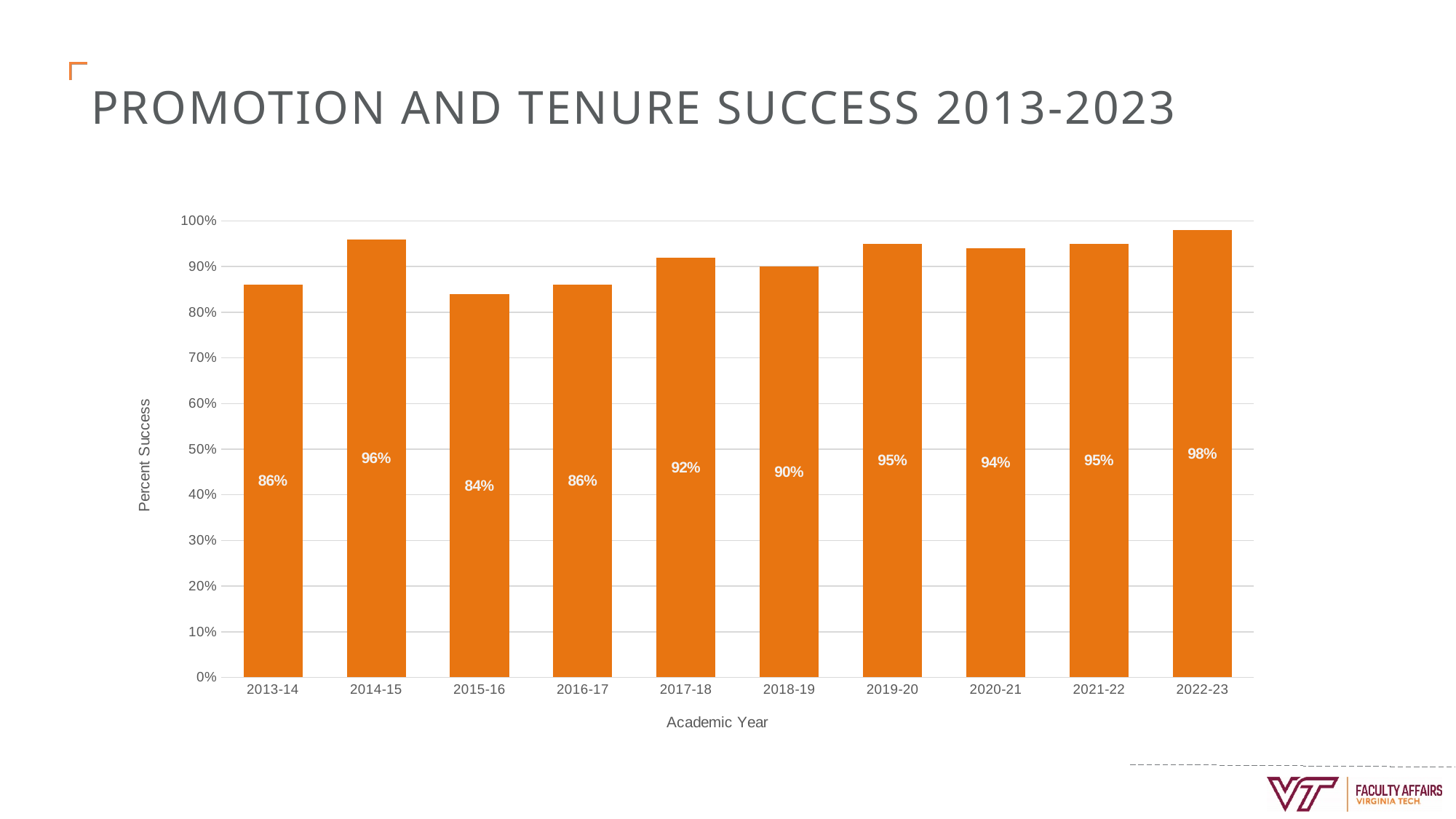
What is the difference in percent success between 2014-15 and 2013-14? 10% How many academic years are shown on the chart? 10 Which academic year has the lowest percent success? 2015-16 What is the percent success for 2020-21? 94% Is the value for 2016-17 greater or less than 90%? less Which academic year has the highest percent success? 2022-23 What kind of chart is shown on the slide? Bar chart What is the percent success for 2018-19? 90% What is the difference in percent success between 2022-23 and 2015-16? 14% What is the percent success for 2013-14? 86% Which has a higher percent success, 2017-18 or 2018-19? 2017-18 What is the label of the y axis? Percent Success